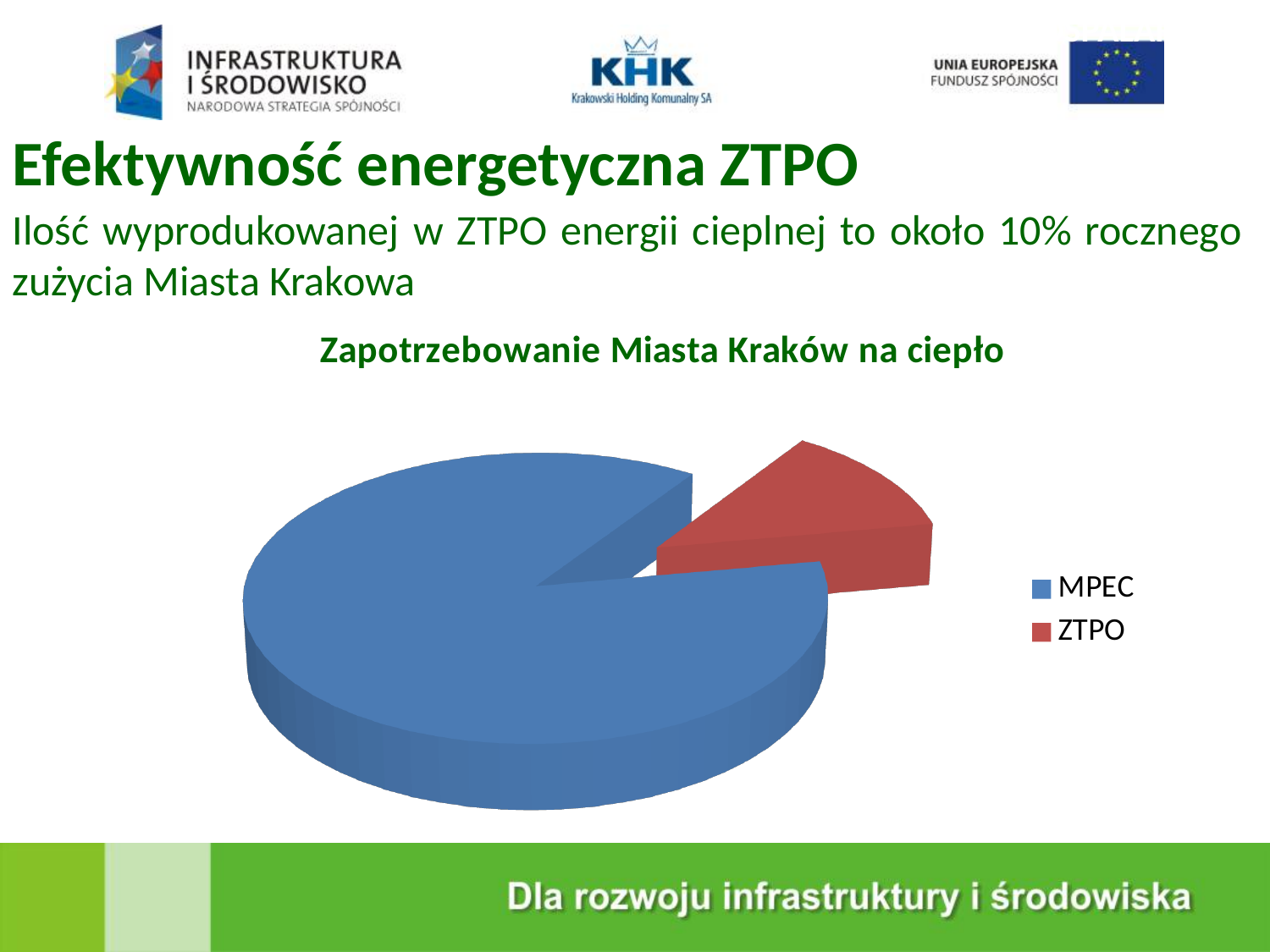
Which slice is larger, MPEC or ZTPO? MPEC What kind of chart is shown on the slide? pie chart What colour is the ZTPO slice in the pie chart? red What is the title of the chart? Zapotrzebowanie Miasta Kraków na ciepło Which category has the smallest slice of the pie? ZTPO Which category is shown in blue in the pie chart? MPEC Which category has the largest slice of the pie? MPEC How many slices does the pie chart have? 2 How many entries does the chart legend list? 2